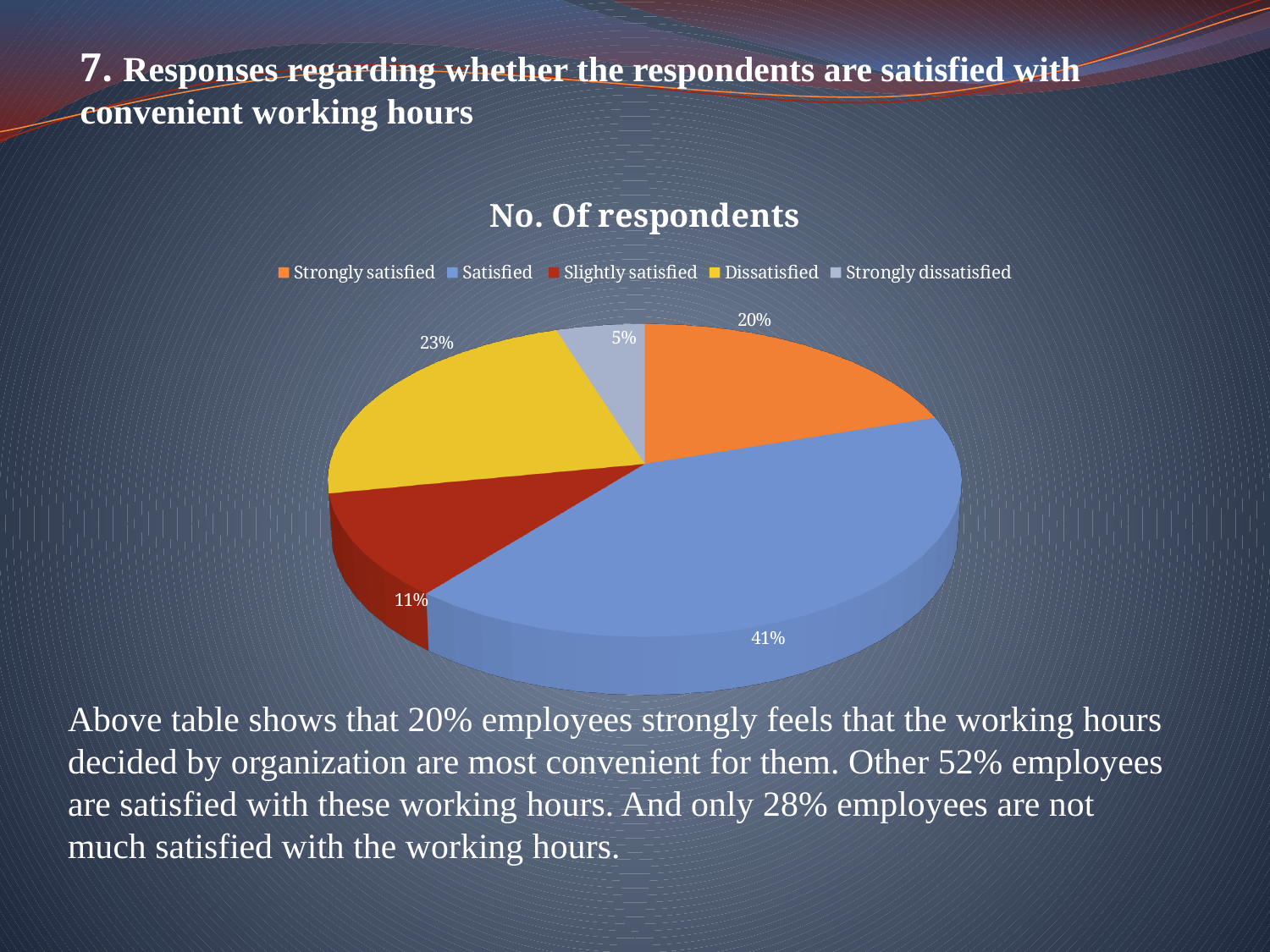
What percentage of respondents are Dissatisfied? 23% What type of chart is shown on the slide? Pie chart Which category has the largest share of the pie? Satisfied What percentage of respondents are Slightly satisfied? 11% What percentage of respondents are Strongly dissatisfied? 5% What is the title of the chart? No. Of respondents What is the difference in percentage points between Satisfied and Dissatisfied? 18 What percentage of respondents are Satisfied? 41% Which is larger, the share for Strongly satisfied or the share for Slightly satisfied? Strongly satisfied What percentage of respondents are Strongly satisfied? 20% How many categories does the legend list? 5 Which category has the smallest share of the pie? Strongly dissatisfied